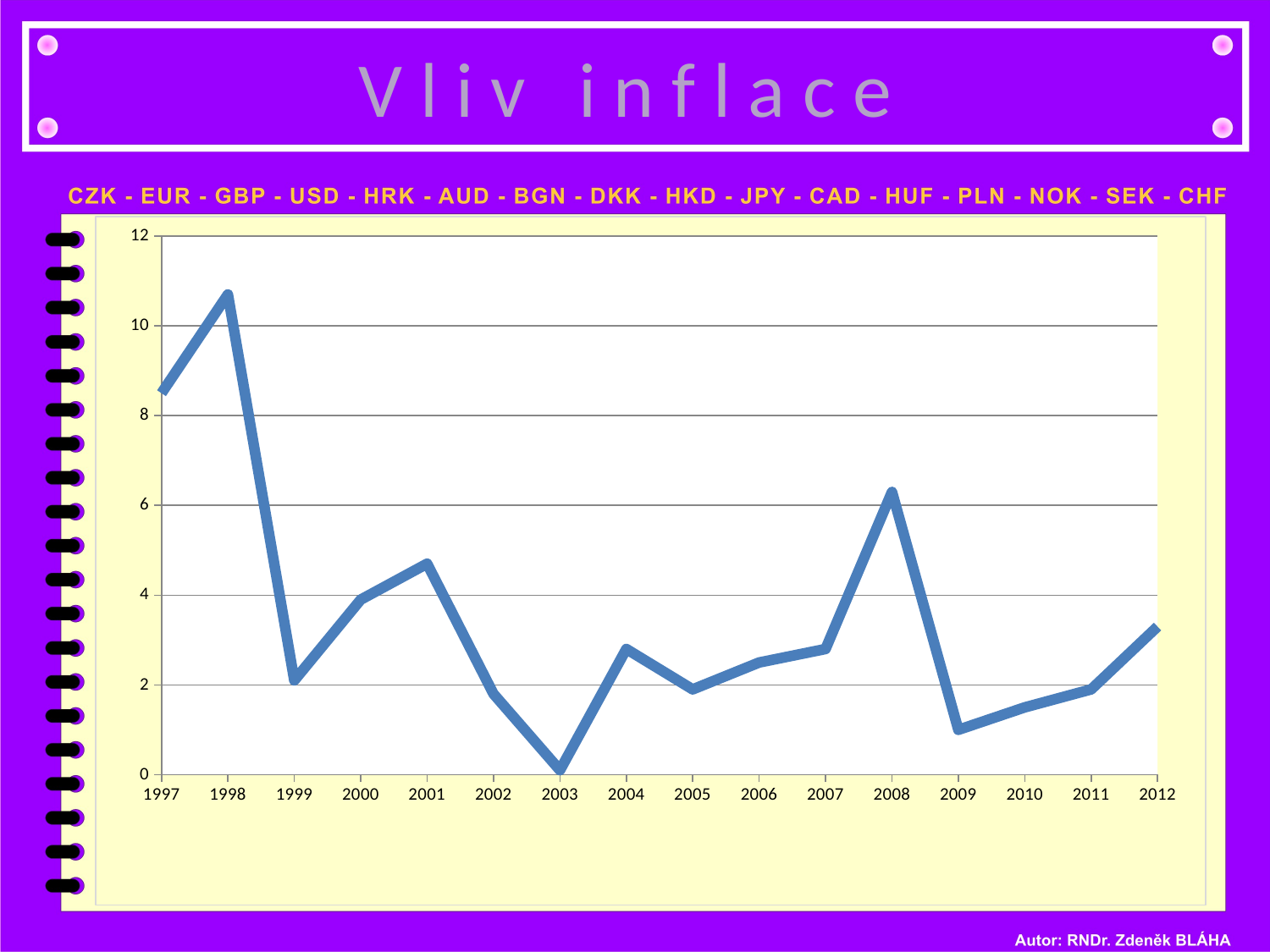
Is the value for 1997 greater or less than 8? greater Is the value for 2008 greater or less than 6? greater Is the value for 2009 greater or less than 2? less How many years are plotted along the x axis of the chart? 16 Which year has the larger value, 2008 or 2012? 2008 Which year has the larger value, 2001 or 2002? 2001 What is the first year shown on the x axis of the chart? 1997 Which year has the lowest value on the chart? 2003 What kind of chart is shown on the slide? line chart Which year has the highest value on the chart? 1998 Does the value rise or fall from 1998 to 1999? fall